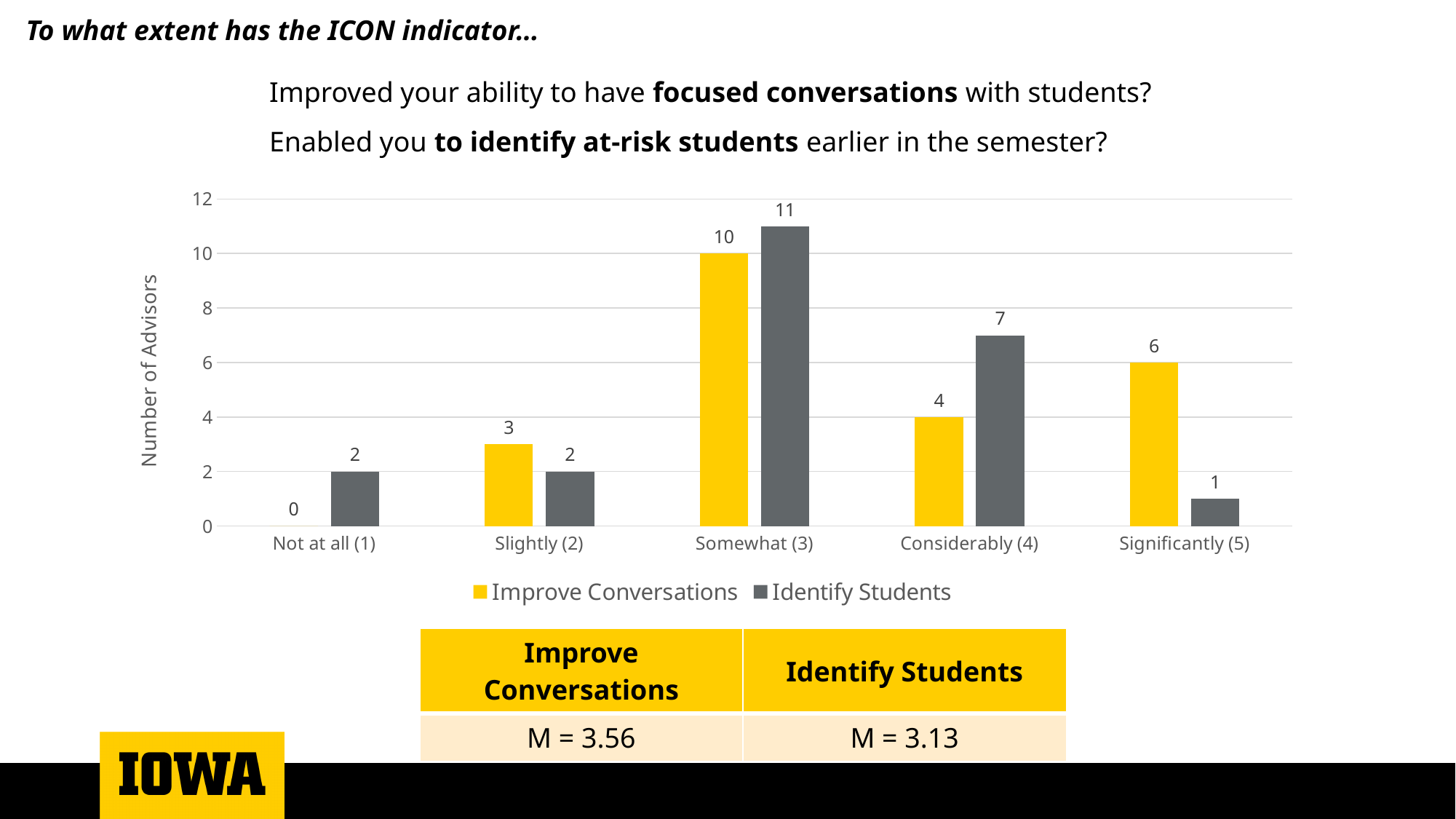
What is the label of the y axis? Number of Advisors What is the value for Improve Conversations at "Not at all (1)"? 0 Which category has the highest value for Identify Students? Somewhat (3) Which category has the lowest value for Improve Conversations? Not at all (1) What is the value for Identify Students at "Considerably (4)"? 7 How many advisors answered "Somewhat (3)" for Improve Conversations? 10 How many series does the legend list? 2 Which colour represents the Identify Students series? Dark grey What kind of chart is shown on the slide? Bar chart At "Considerably (4)", which series has the larger value, Improve Conversations or Identify Students? Identify Students How many categories are shown on the x axis? 5 What is the difference between Improve Conversations and Identify Students at "Significantly (5)"? 5